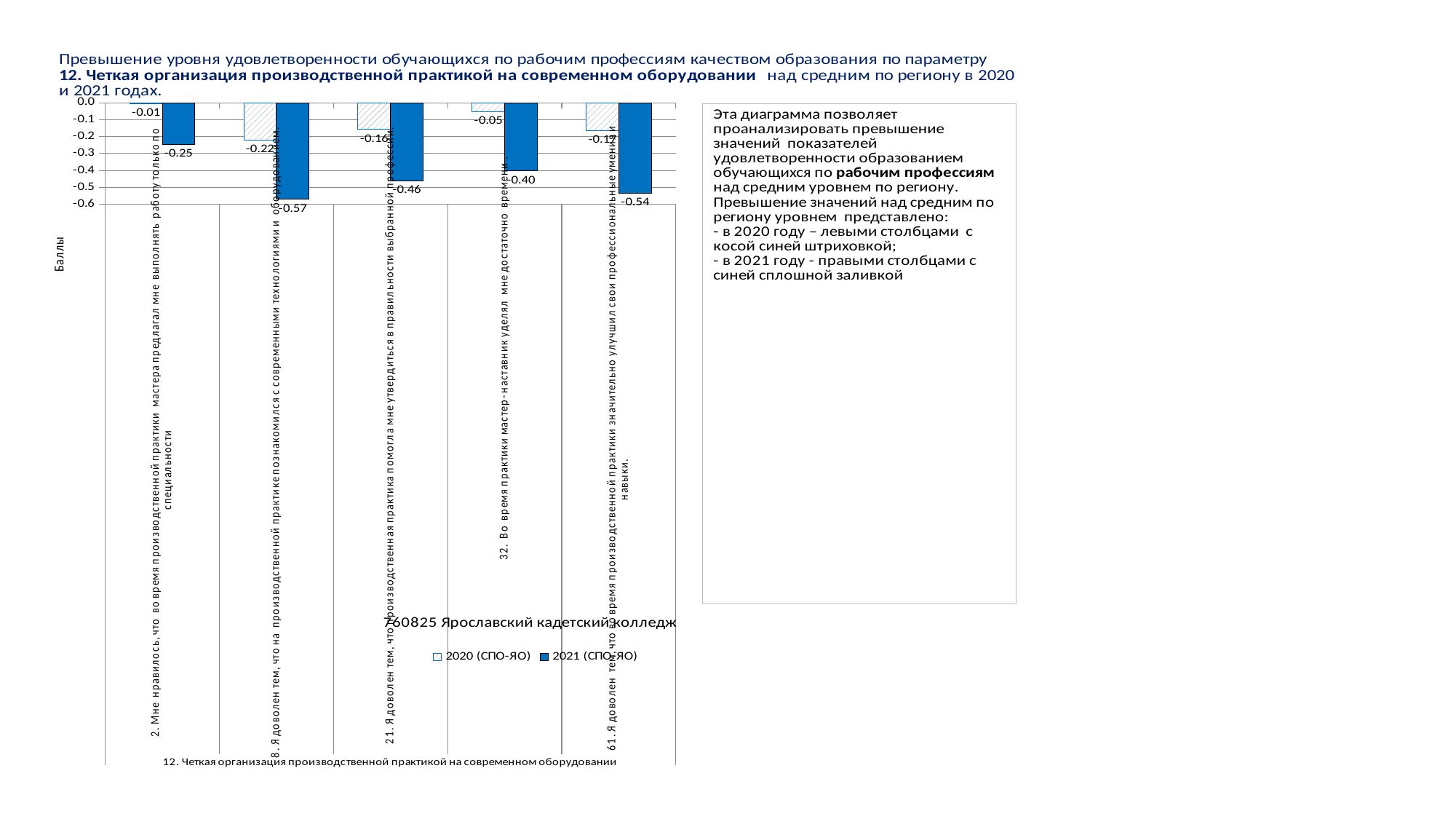
What is the 2021 (СПО-ЯО) value for category 32 (Во время практики мастер-наставник уделял мне достаточно времени)? -0.40 What is the difference between the 2021 (СПО-ЯО) values for category 8 and category 2? 0.32 What is the 2021 (СПО-ЯО) value for category 8 (Я доволен тем, что на производственной практике познакомился с современными технологиями и оборудованием)? -0.57 Which category has the lowest 2021 (СПО-ЯО) value? 8. Я доволен тем, что на производственной практике познакомился с современными технологиями и оборудованием Which category has the highest 2020 (СПО-ЯО) value? 2. Мне нравилось, что во время производственной практики мастера предлагал мне выполнять работу только по специальности What is the 2020 (СПО-ЯО) value for category 2 (Мне нравилось, что во время производственной практики мастера предлагал мне выполнять работу только по специальности)? -0.01 What is the 2020 (СПО-ЯО) value for category 21 (Я доволен тем, что производственная практика помогла мне утвердиться в правильности выбранной профессии)? -0.16 Which is larger for category 61: the 2021 (СПО-ЯО) value or the 2021 (СПО-ЯО) value for category 21? category 21 (-0.46) How many series does the chart legend list? 2 What type of chart is shown on the slide? bar chart How many categories (questions) are plotted on the chart? 5